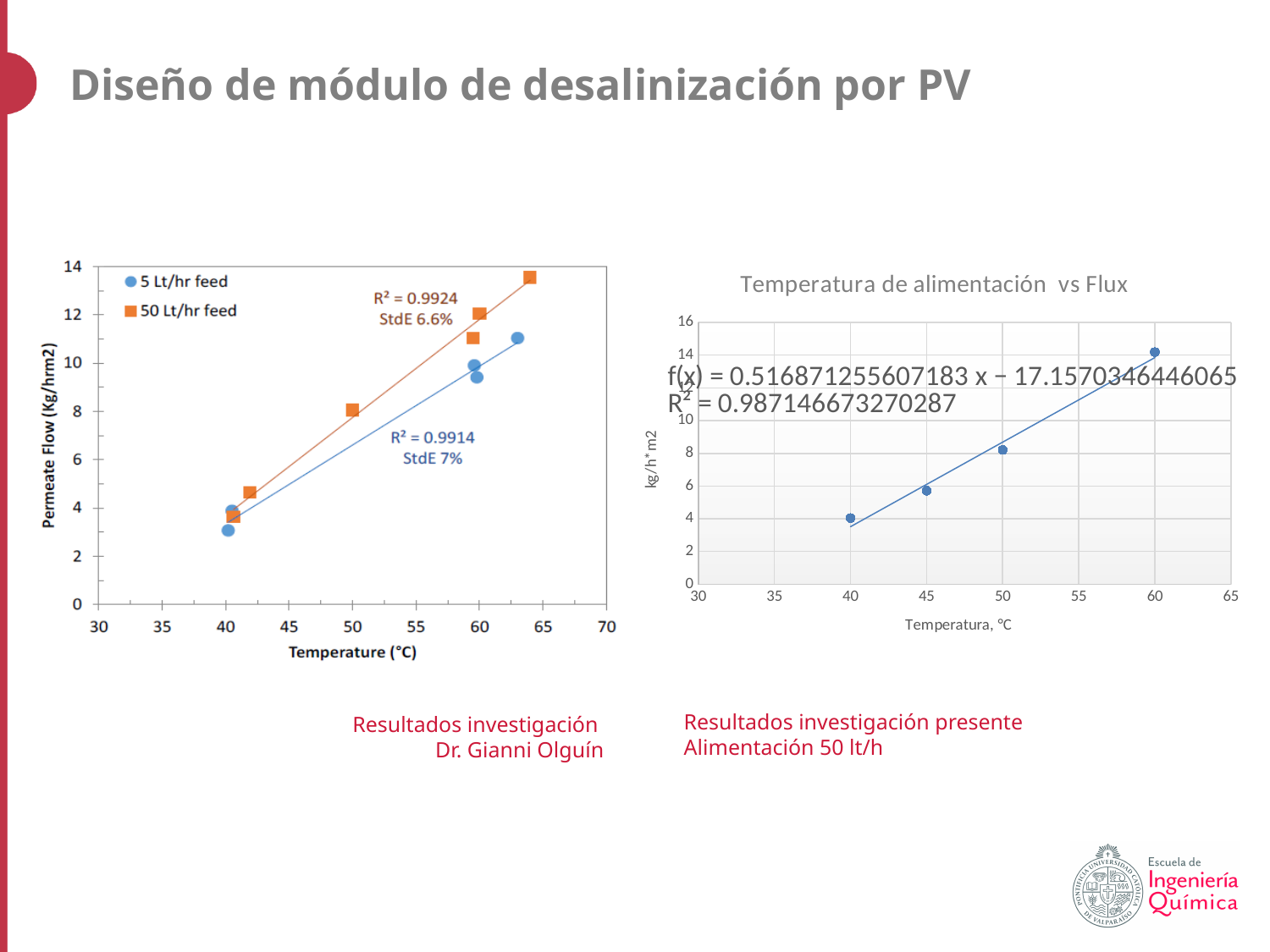
In the chart 'Temperatura de alimentación vs Flux', how many data points are plotted? 4 In the chart 'Temperatura de alimentación vs Flux', does the flux rise or fall as temperature increases? rise In the left-hand chart (Permeate Flow vs Temperature), what R² value is shown for the 50 Lt/hr feed series? 0.9924 In the left-hand chart (Permeate Flow vs Temperature), is the permeate flow of the 50 Lt/hr feed series at about 64 °C greater or less than 12? greater In the left-hand chart (Permeate Flow vs Temperature), which series has the higher permeate flow at 60 °C, 5 Lt/hr feed or 50 Lt/hr feed? 50 Lt/hr feed How many series does the legend of the left-hand chart (Permeate Flow vs Temperature) list? 2 What kind of chart is the right-hand chart titled 'Temperatura de alimentación vs Flux'? scatter chart In the chart 'Temperatura de alimentación vs Flux', is the flux at 60 °C greater or less than 12? greater In the chart 'Temperatura de alimentación vs Flux', is the flux at 40 °C greater or less than 6? less In the chart 'Temperatura de alimentación vs Flux', at which temperature is the flux highest? 60 °C In the chart 'Temperatura de alimentación vs Flux', at which temperature is the flux lowest? 40 °C In the chart 'Temperatura de alimentación vs Flux', what R² value is printed for the trendline? 0.987146673270287